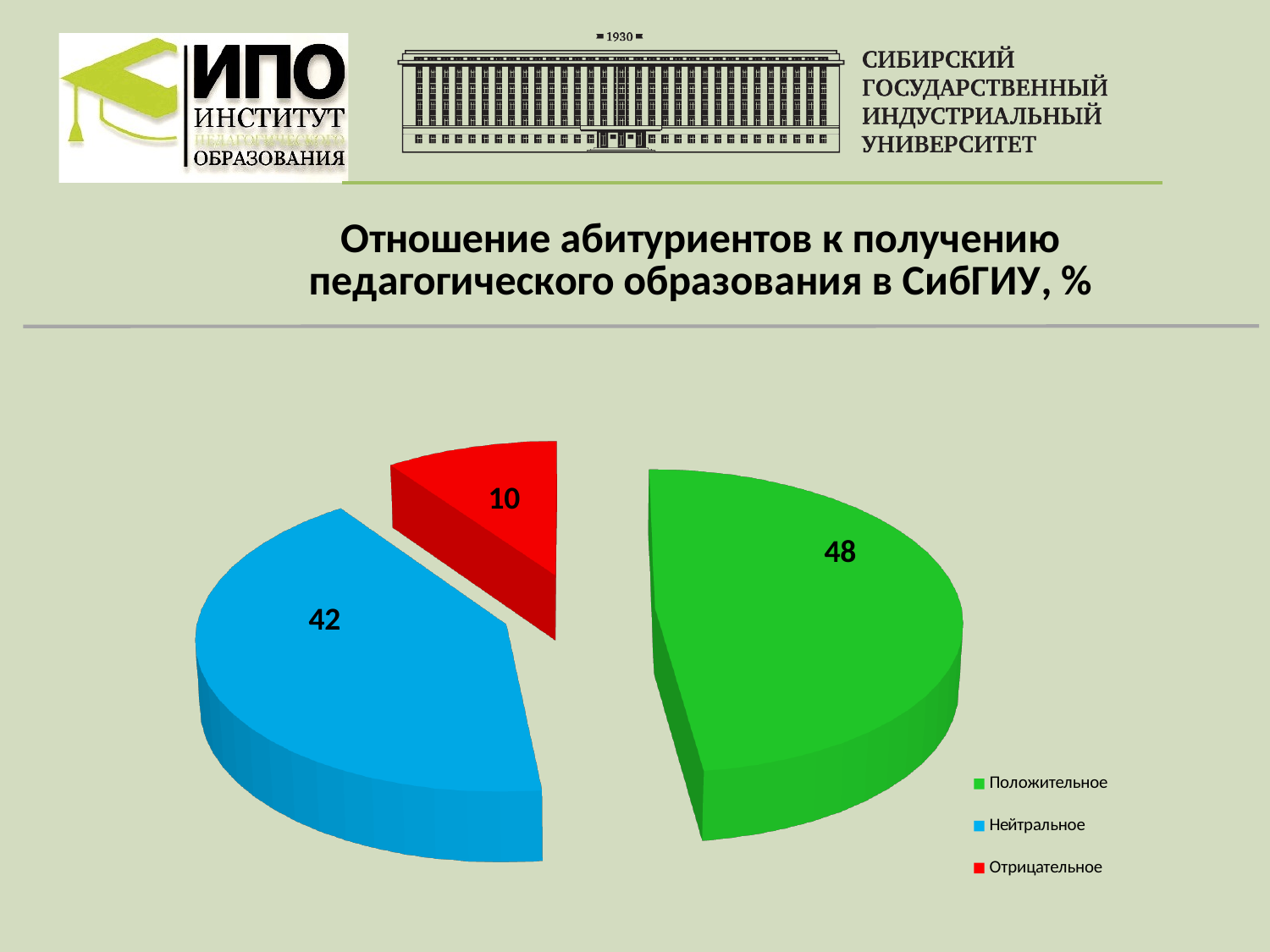
What value is shown for the Нейтральное slice? 42 What colour is the Отрицательное slice? red What is the difference between the Положительное and Нейтральное values? 6 What kind of chart is shown on the slide? pie chart What is the difference between the Нейтральное and Отрицательное values? 32 Which category has the smallest slice? Отрицательное Which is larger, the Нейтральное value or the Отрицательное value? Нейтральное Which category has the largest slice? Положительное What is the title of the chart? Отношение абитуриентов к получению педагогического образования в СибГИУ, % How many slices does the pie chart have? 3 What value is shown for the Положительное slice? 48 What value is shown for the Отрицательное slice? 10